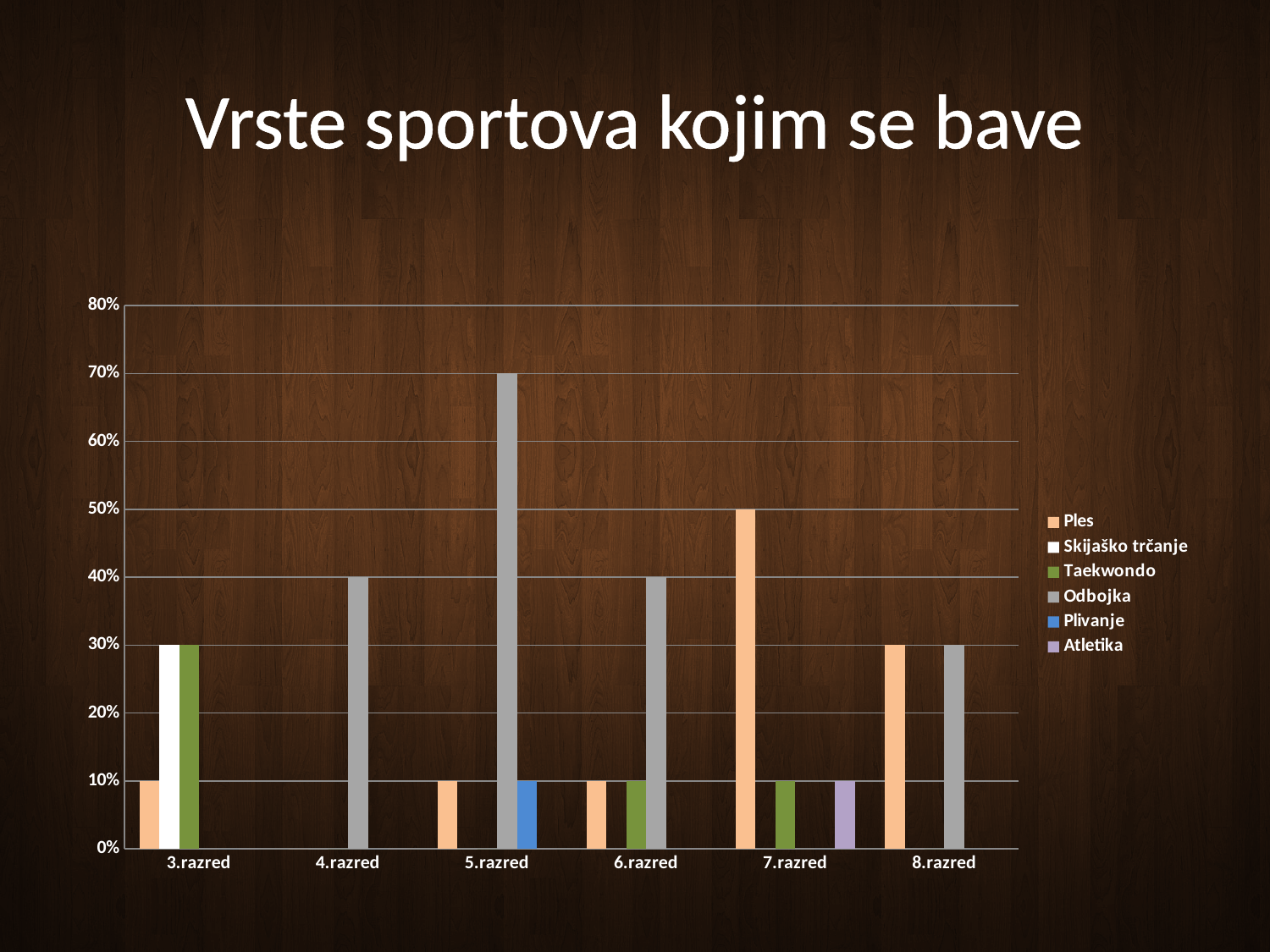
What type of chart is shown on the slide? bar chart How many series does the legend list? 6 How many categories (razred groups) are shown on the x axis? 6 Which is larger: Ples in 7.razred or Ples in 8.razred? Ples in 7.razred What is the title of the chart? Vrste sportova kojim se bave In which category does Odbojka reach its highest value? 5.razred In which category does the Atletika series appear? 7.razred What is the difference between Odbojka in 5.razred and Odbojka in 4.razred? 30% What is the value for Ples in 7.razred? 50% What is the value for Skijaško trčanje in 3.razred? 30% Is the value for Odbojka in 5.razred greater or less than 60%? greater What is the value for Odbojka in 5.razred? 70%